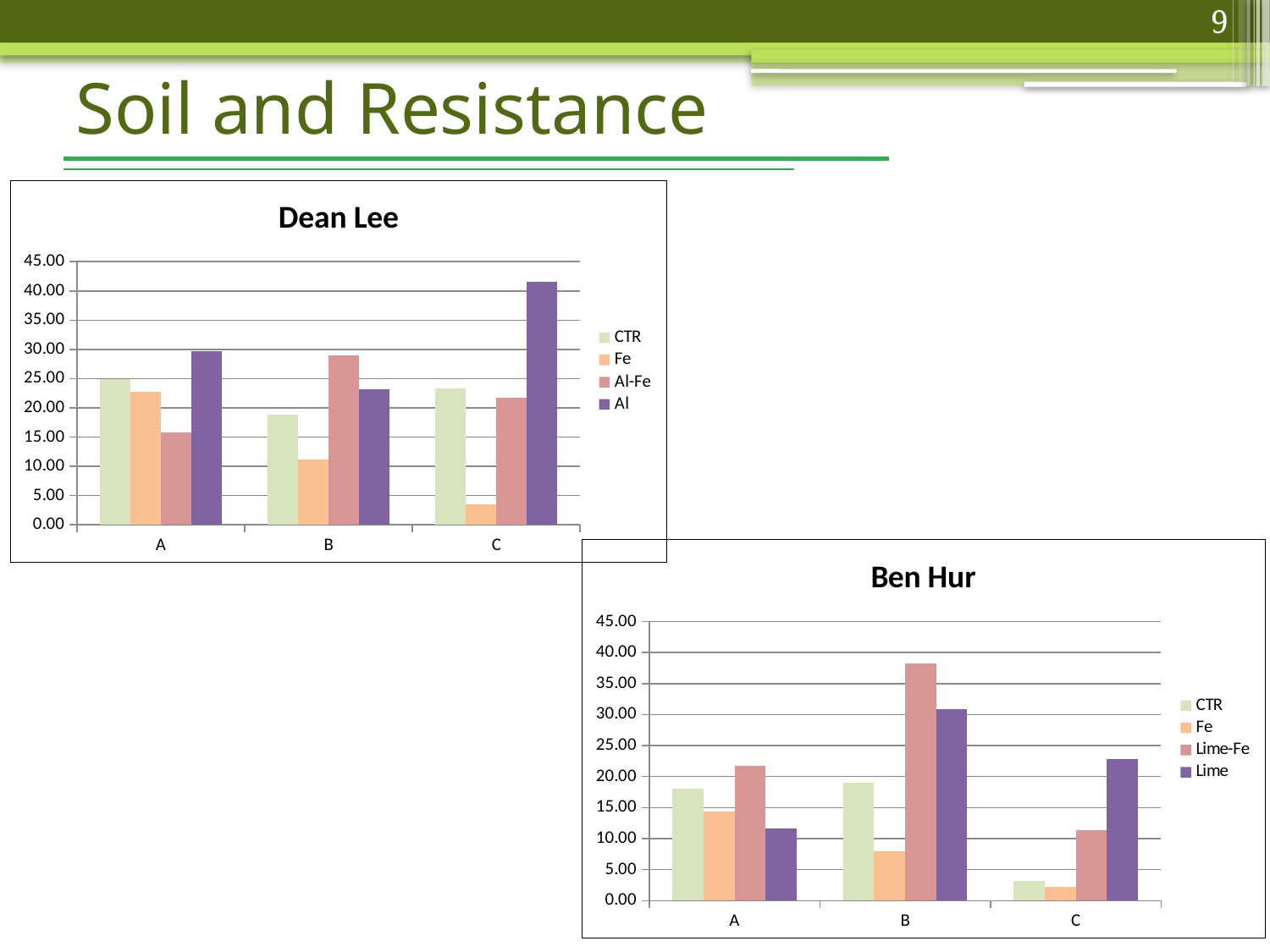
In the Dean Lee chart, is the Fe value for C greater or less than 5.00? less In the Dean Lee chart, how many categories are shown on the x axis? 3 In the Ben Hur chart, what are the legend entries? CTR, Fe, Lime-Fe, Lime In the Dean Lee chart, which category has the highest Al value? C In the Dean Lee chart, is the Al value for C greater or less than 40.00? greater In the Dean Lee chart, how many series does the legend list? 4 In the Dean Lee chart, for category B, which is larger: Al-Fe or Al? Al-Fe In the Ben Hur chart, which category has the lowest CTR value? C In the Dean Lee chart, what kind of chart is shown? bar chart In the Ben Hur chart, is the Lime-Fe value for B greater or less than 35.00? greater In the Ben Hur chart, which category has the highest Lime-Fe value? B In the Ben Hur chart, how many series does the legend list? 4